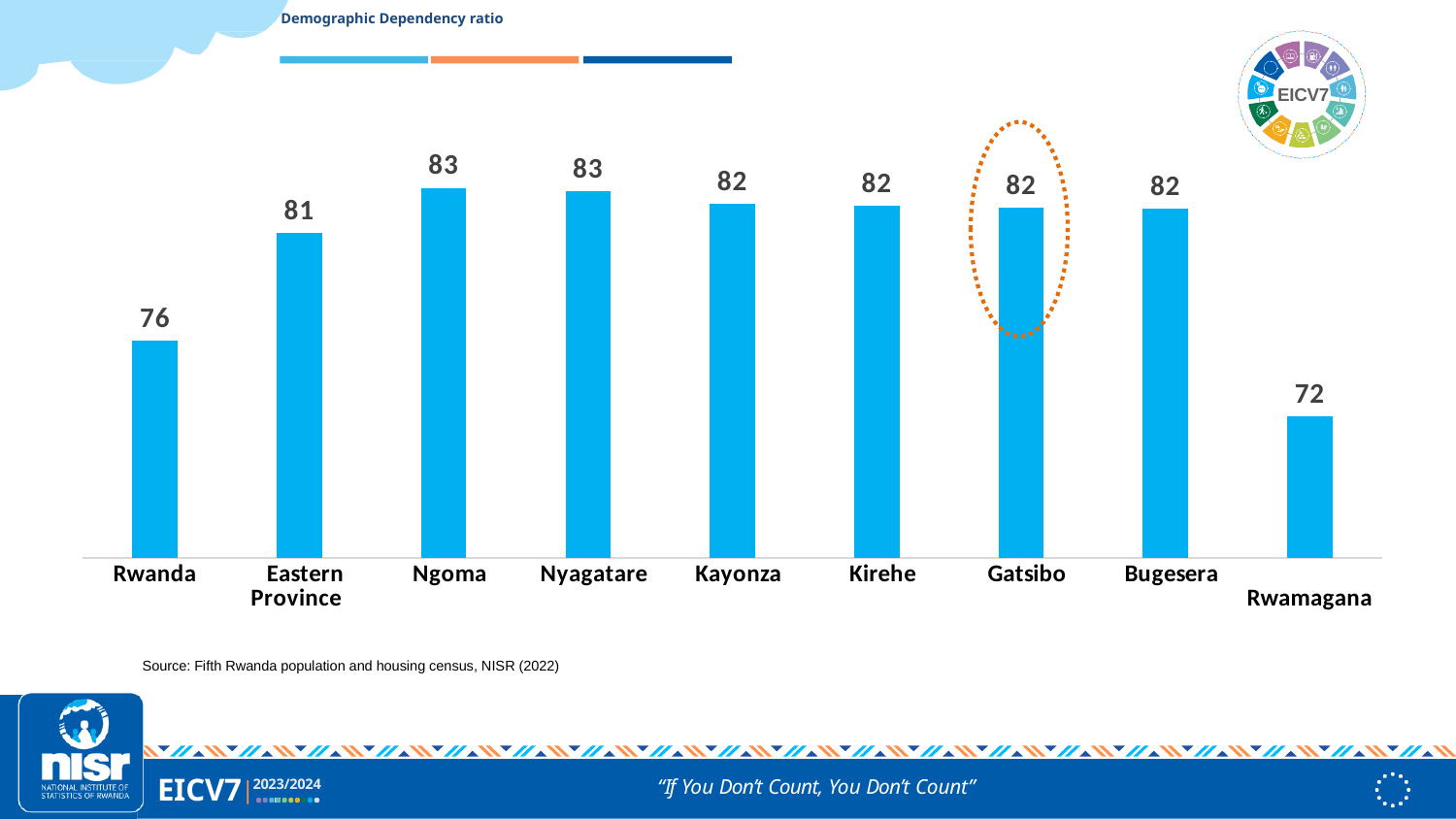
Which category has the lowest demographic dependency ratio? Rwamagana What is the demographic dependency ratio for Rwanda? 76 What is the difference between the demographic dependency ratio of Eastern Province and Rwanda? 5 How many categories are shown in the chart? 9 What is the demographic dependency ratio for Rwamagana? 72 What is the demographic dependency ratio for Gatsibo? 82 What is the difference between the demographic dependency ratio of Ngoma and Rwamagana? 11 Which has a higher demographic dependency ratio, Rwanda or Rwamagana? Rwanda What is the demographic dependency ratio for Ngoma? 83 Which category's bar is highlighted with a dotted orange circle? Gatsibo What is the demographic dependency ratio for Eastern Province? 81 What kind of chart is shown on the slide? Bar chart